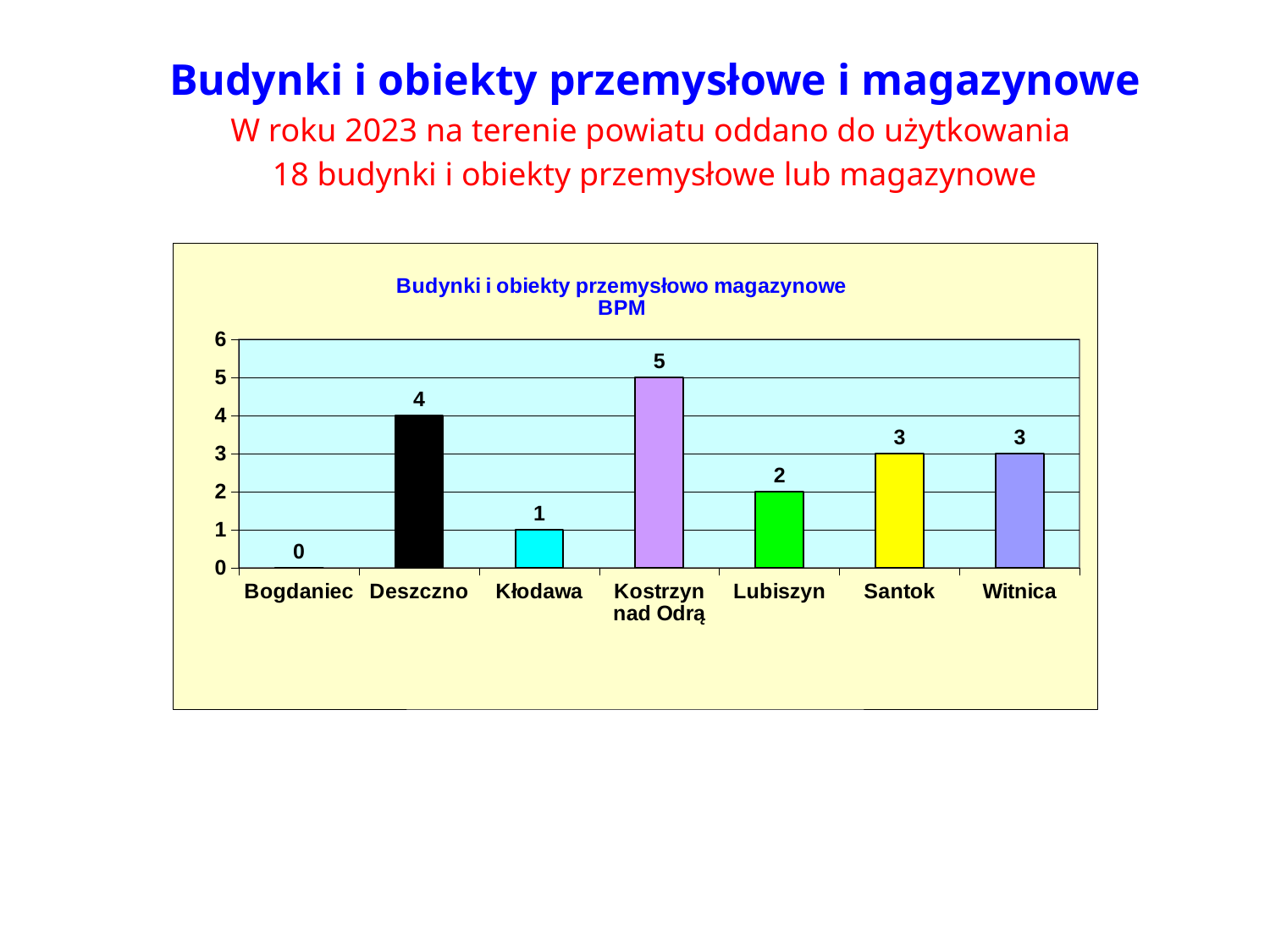
Which is larger, the value for Deszczno or the value for Santok? Deszczno What is the value for Lubiszyn? 2 What is the value for Deszczno? 4 What is the difference between the values for Kostrzyn nad Odrą and Kłodawa? 4 Which category has the lowest value? Bogdaniec What is the value for Kostrzyn nad Odrą? 5 What is the title of the chart? Budynki i obiekty przemysłowo magazynowe BPM How many categories are shown on the x axis? 7 What is the value for Bogdaniec? 0 Which category has the highest value? Kostrzyn nad Odrą What kind of chart is shown? bar chart What colour is the bar for Santok? yellow